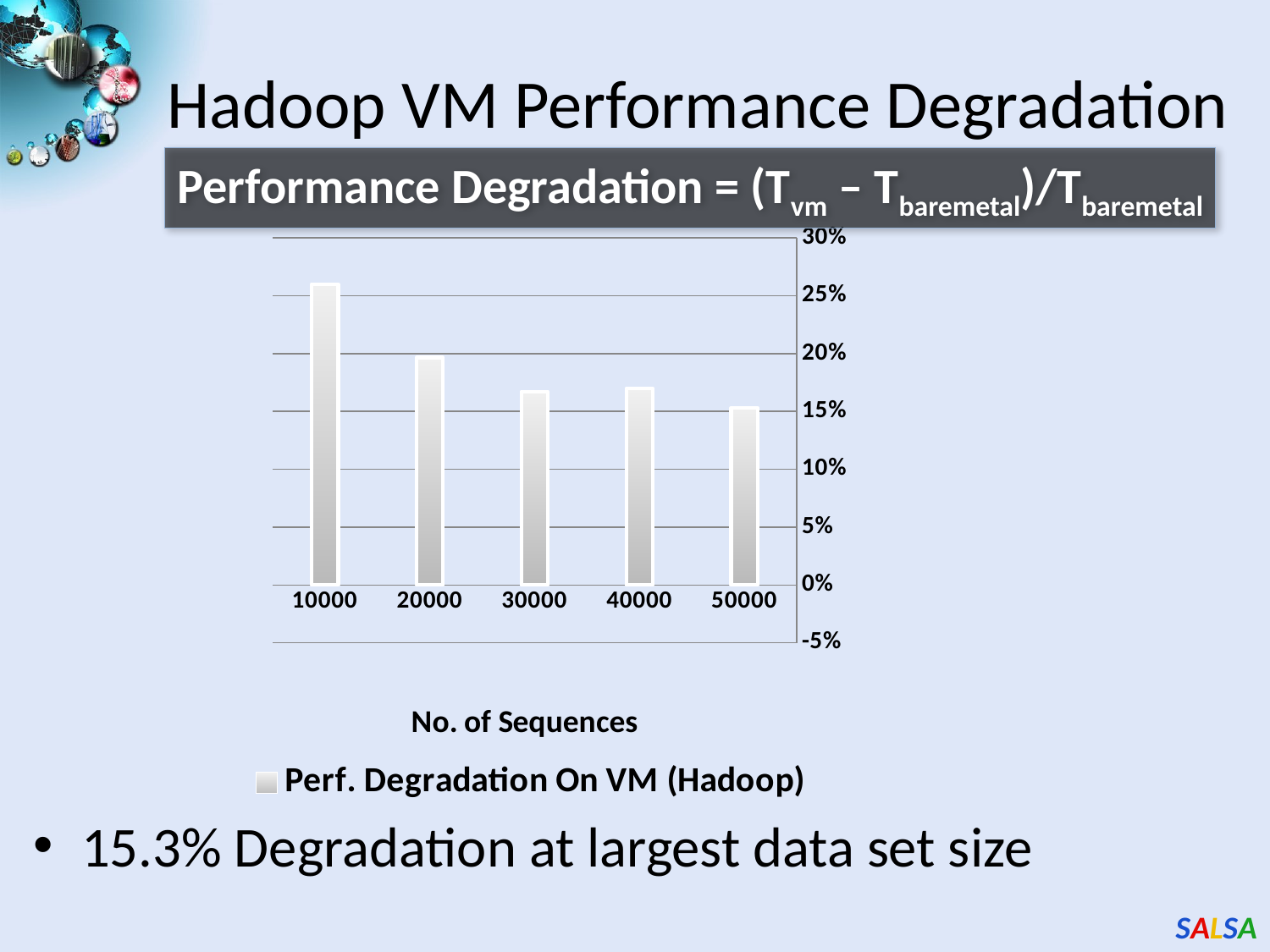
How many categories (numbers of sequences) are plotted on the x axis? 5 What is the series name shown in the chart legend? Perf. Degradation On VM (Hadoop) Which number of sequences has the lowest performance degradation? 50000 Which has the larger performance degradation, 10000 sequences or 20000 sequences? 10000 Which number of sequences has the highest performance degradation? 10000 What kind of chart is shown on the slide? bar chart Is the value for 20000 sequences greater or less than 25%? less Is the value for 30000 sequences greater or less than 20%? less Do the performance degradation values generally rise or fall as the number of sequences increases? fall Is the value for 50000 sequences greater or less than 10%? greater How many series does the chart legend list? 1